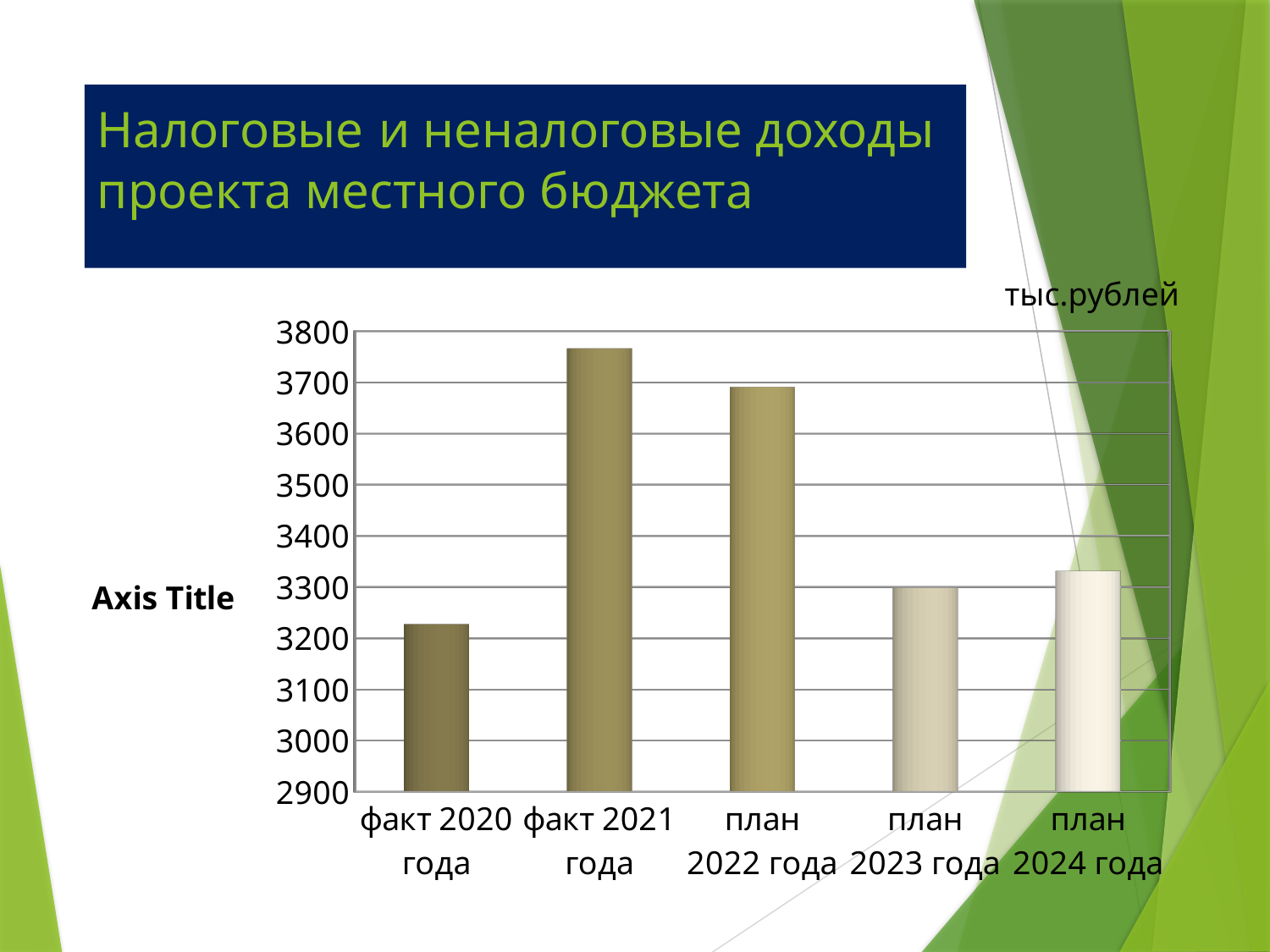
What unit is indicated above the chart? тыс.рублей Which category has the lowest bar in the chart? факт 2020 года Is the value for план 2022 года greater or less than 3600? greater How many categories are shown on the x axis of the chart? 5 Is the value for план 2024 года greater or less than 3400? less What is the title of the slide containing the chart? Налоговые и неналоговые доходы проекта местного бюджета Is the value for факт 2020 года greater or less than 3300? less What kind of chart is shown on the slide? bar chart Which is larger, the value for факт 2021 года or the value for план 2022 года? факт 2021 года Which is larger, the value for факт 2020 года or the value for план 2023 года? план 2023 года Which category has the highest bar in the chart? факт 2021 года